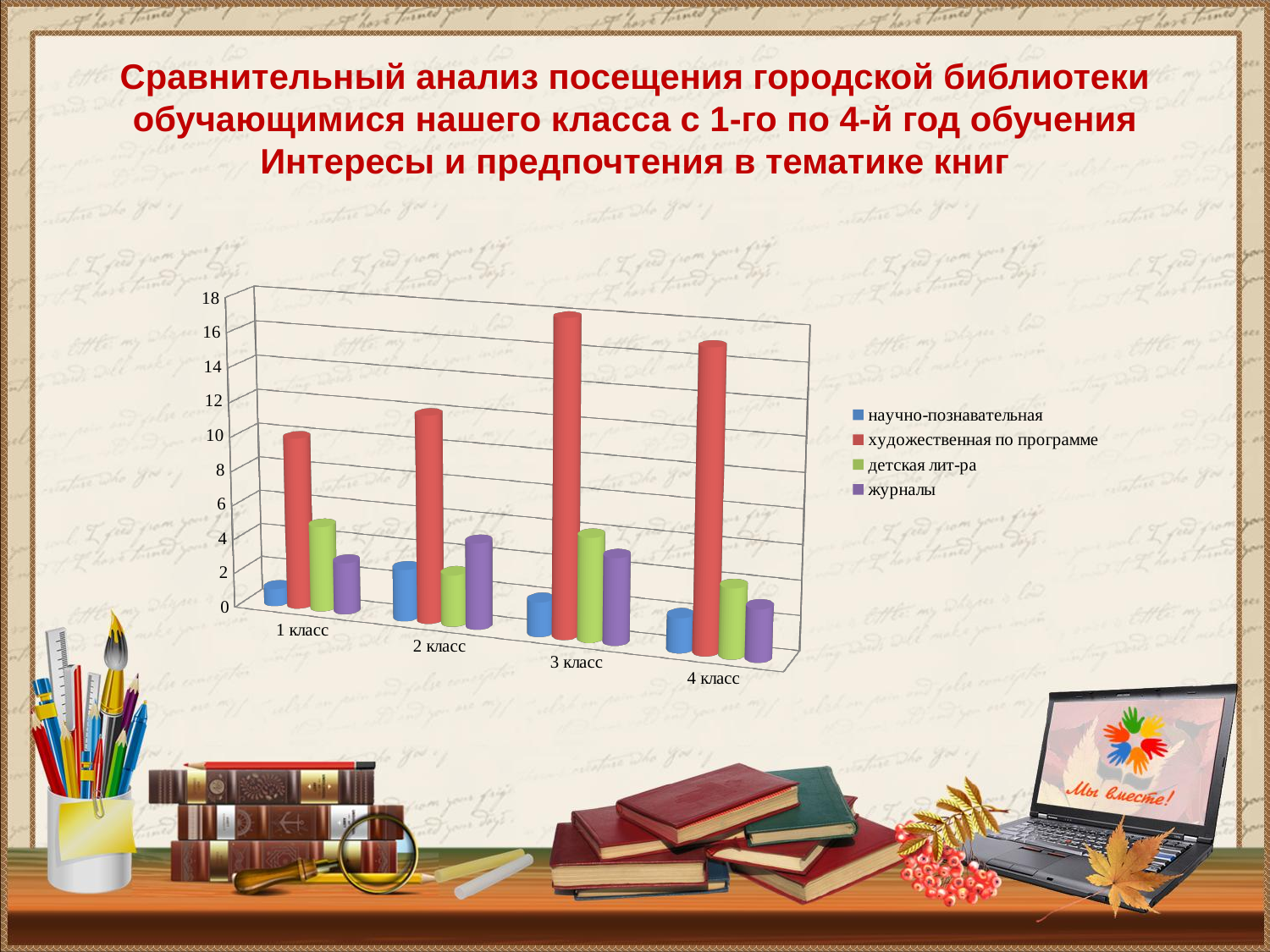
What colour represents the журналы series in the chart? purple Is the value for художественная по программе in 1 класс greater or less than 14? less What kind of chart is shown on the slide? bar chart Which is larger: детская лит-ра in 1 класс or in 2 класс? 1 класс Is the value for научно-познавательная in 2 класс greater or less than 6? less Which class has the highest value for художественная по программе? 3 класс Which is larger: художественная по программе in 3 класс or in 4 класс? 3 класс How many classes (categories) are shown on the x axis of the chart? 4 How many series does the chart legend list? 4 Which series has the highest value in 1 класс? художественная по программе Is the value for художественная по программе in 3 класс greater or less than 14? greater